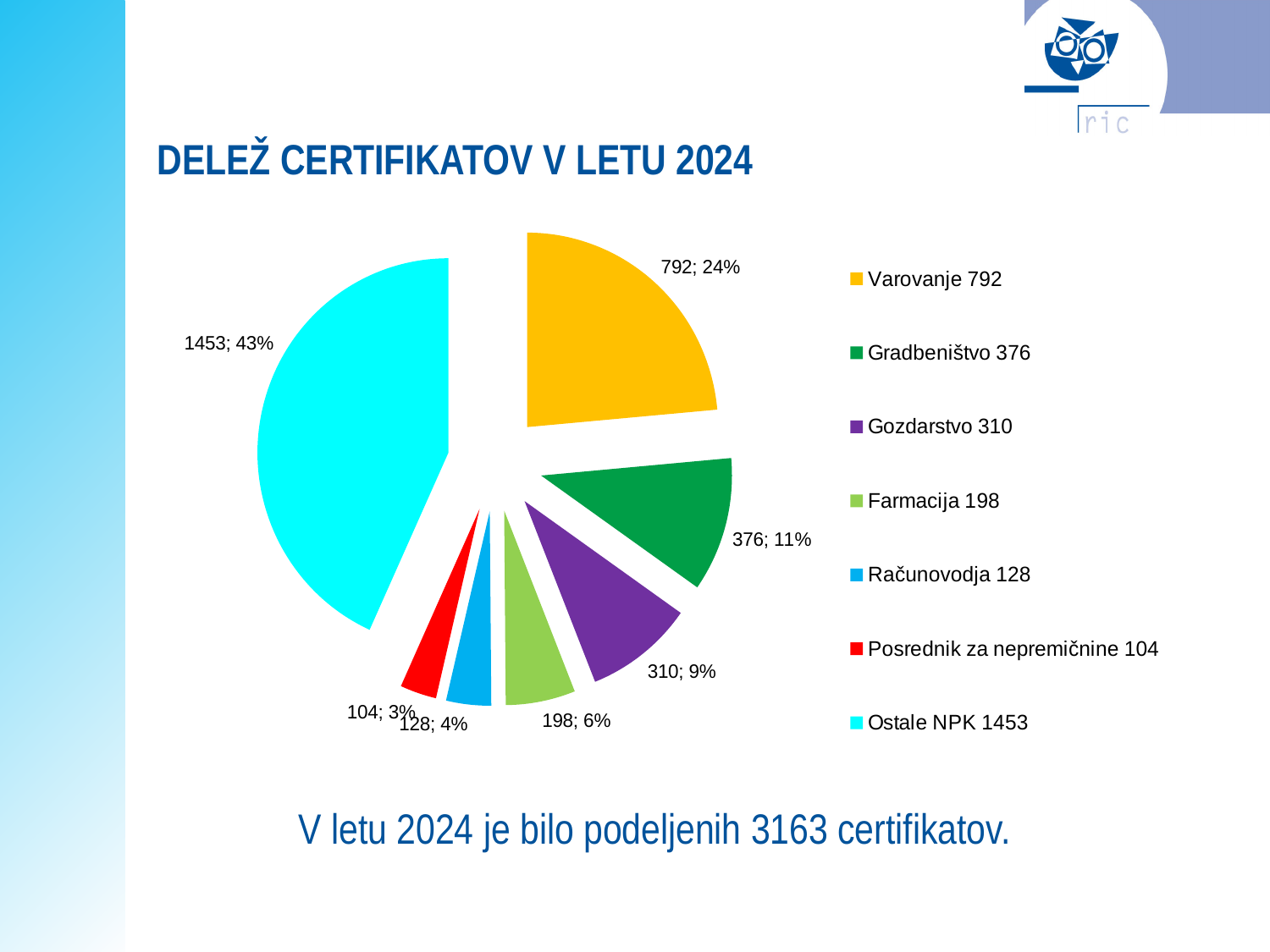
How many slices does the pie chart have? 7 What is the title of the chart? DELEŽ CERTIFIKATOV V LETU 2024 What percentage share does Ostale NPK have? 43% What colour is the slice for Farmacija? light green What percentage share does Gradbeništvo have? 11% Which is larger, the value for Gozdarstvo or the value for Farmacija? Gozdarstvo What is the value for Računovodja? 128 Which category has the smallest slice? Posrednik za nepremičnine What kind of chart is shown on the slide? pie chart What is the difference between the values for Varovanje and Gradbeništvo? 416 What is the value for Varovanje? 792 Which category has the largest slice? Ostale NPK